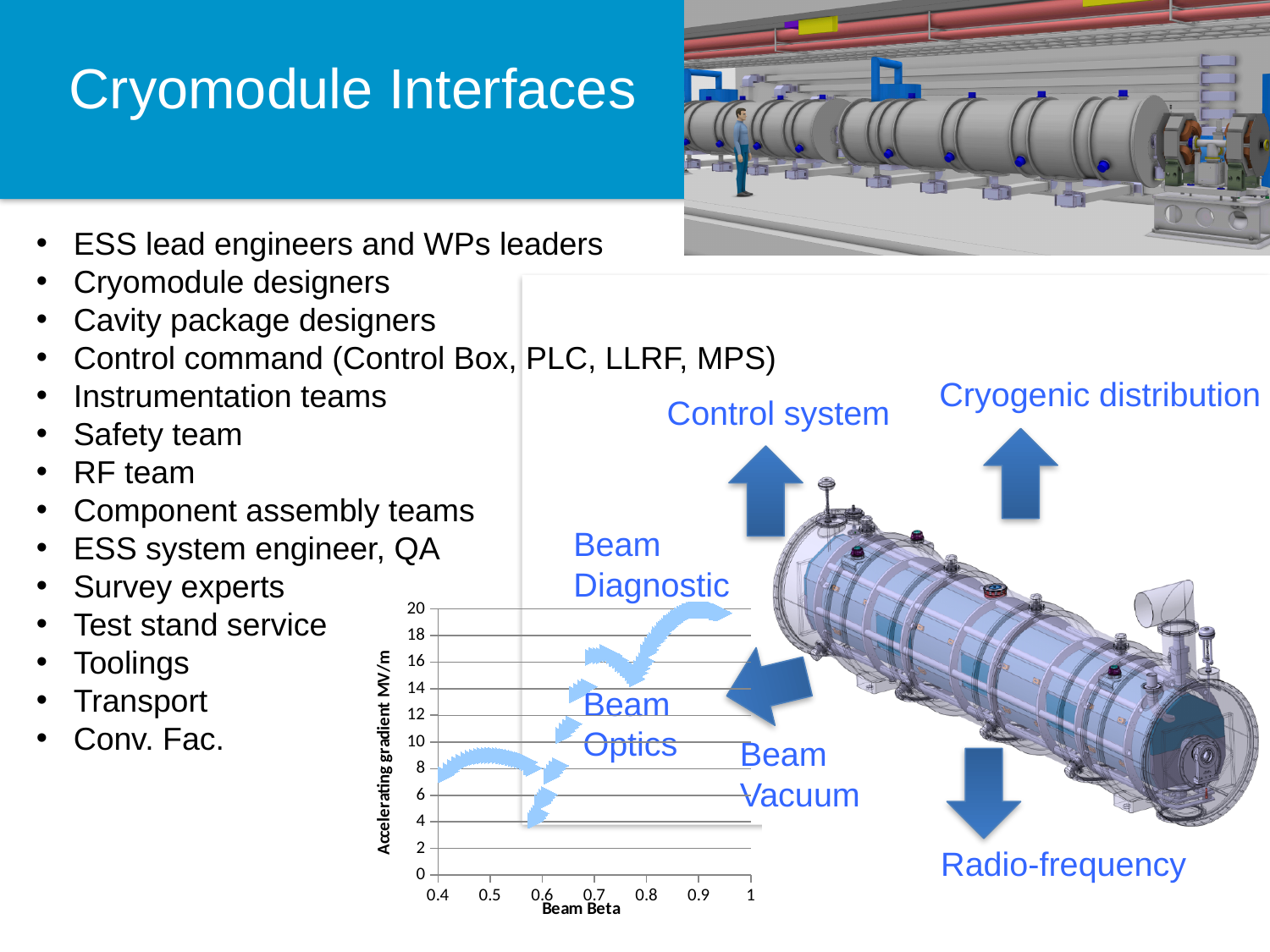
Does the accelerating gradient of the leftmost curve rise or fall as Beam Beta increases from 0.4 to 0.5? rise Is the peak accelerating gradient of the leftmost curve (around Beam Beta 0.5) greater or less than 12? less What is the highest value shown on the vertical axis of the chart? 20 What is the label of the vertical axis of the chart? Accelerating gradient MV/m How many tick labels are shown on the horizontal axis of the chart? 7 What is the lowest value shown on the horizontal axis of the chart? 0.4 Is the peak accelerating gradient of the leftmost curve (around Beam Beta 0.5) greater or less than 6? greater Which curve reaches a higher accelerating gradient: the leftmost curve or the middle curve? the middle curve What is the label of the horizontal axis of the chart? Beam Beta What is the spacing between consecutive tick labels on the vertical axis of the chart? 2 Is the peak accelerating gradient of the middle curve (around Beam Beta 0.7) greater or less than 14? greater What kind of chart is shown at the bottom of the slide? scatter chart